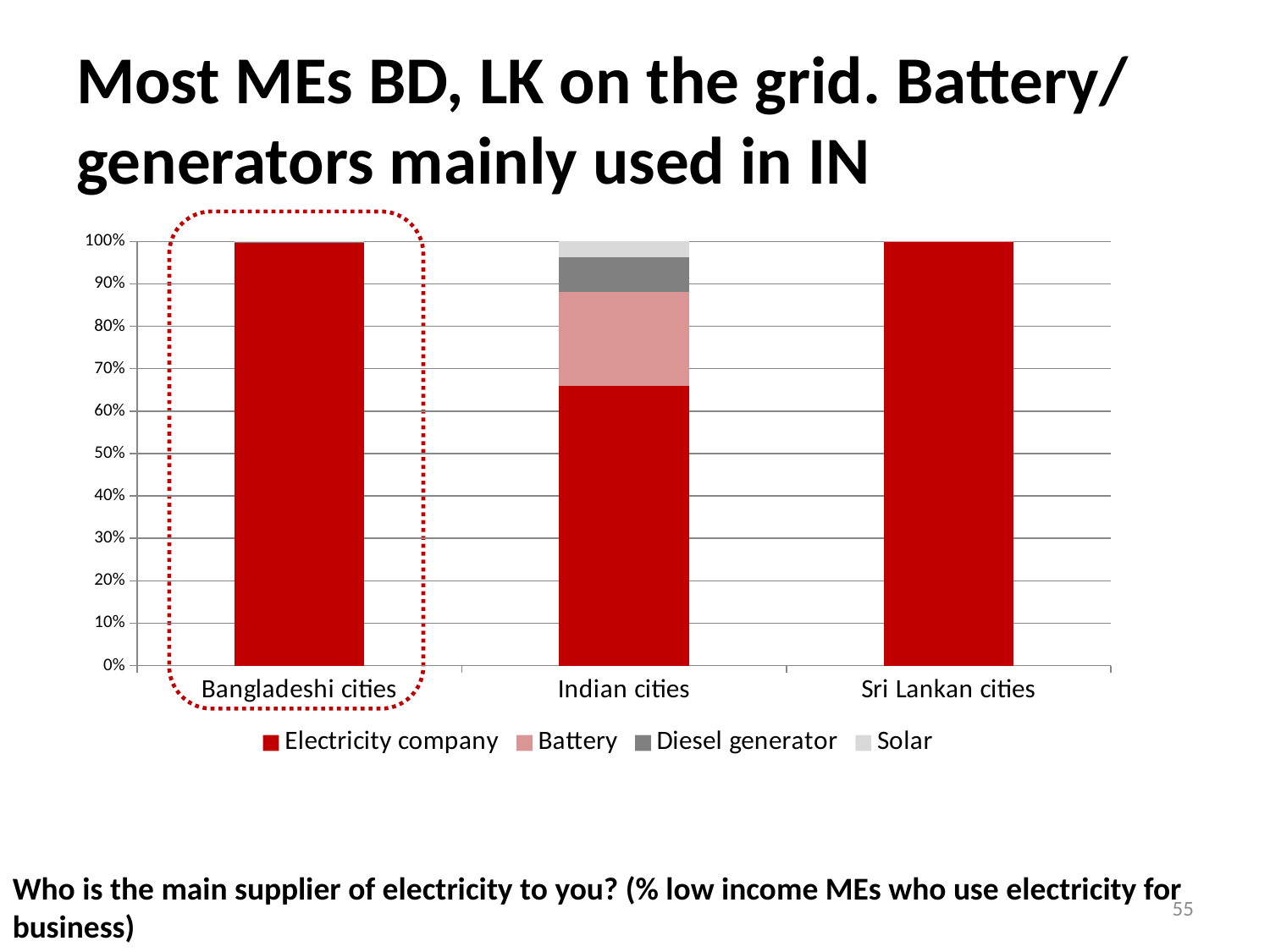
Which category has the lowest share for Electricity company? Indian cities How many city groups (categories) are shown on the x axis? 3 Which category shows a Battery segment in its bar? Indian cities How many series does the legend list? 4 Which is larger, the Electricity company share for Bangladeshi cities or for Indian cities? Bangladeshi cities Is the Electricity company share for Bangladeshi cities greater or less than 90%? greater Is the Electricity company share for Indian cities greater or less than 70%? less What kind of chart is shown on the slide? Stacked bar chart Which category is highlighted with a dotted red outline? Bangladeshi cities Is the Battery share for Indian cities greater or less than 30%? less Which series is shown in dark red in the legend? Electricity company